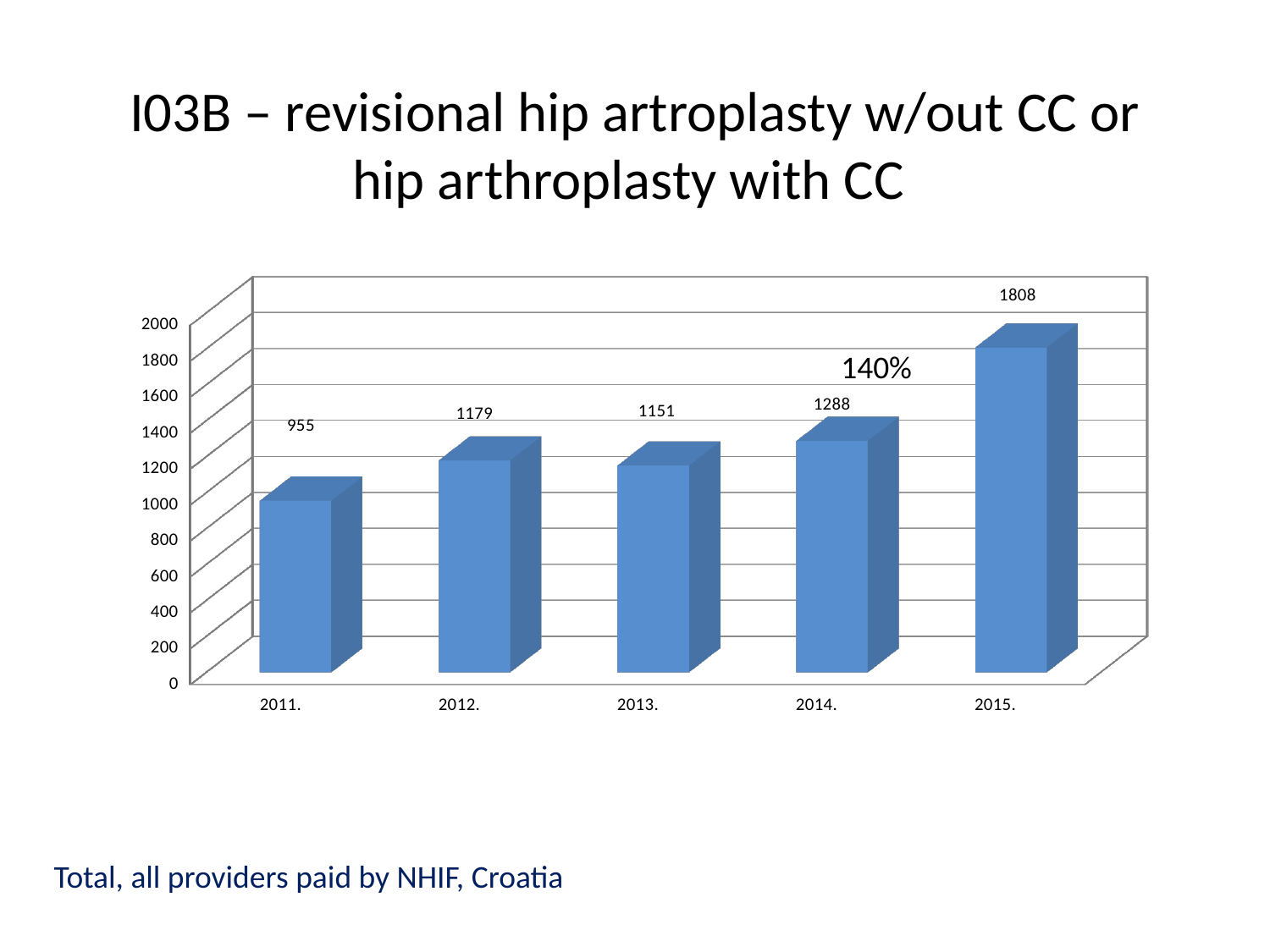
Which year has the highest value? 2015. What is the difference between the values for 2015. and 2014.? 520 What is the value for 2015.? 1808 How many years are shown on the x axis? 5 What percentage annotation is printed above the 2014. bar? 140% Which is larger, the value for 2012. or the value for 2013.? 2012. What kind of chart is shown on the slide? bar chart Which year has the lowest value? 2011. Do the values generally rise or fall from 2011. to 2015.? rise What is the value for 2014.? 1288 What is the value for 2011.? 955 What is the difference between the values for 2012. and 2013.? 28